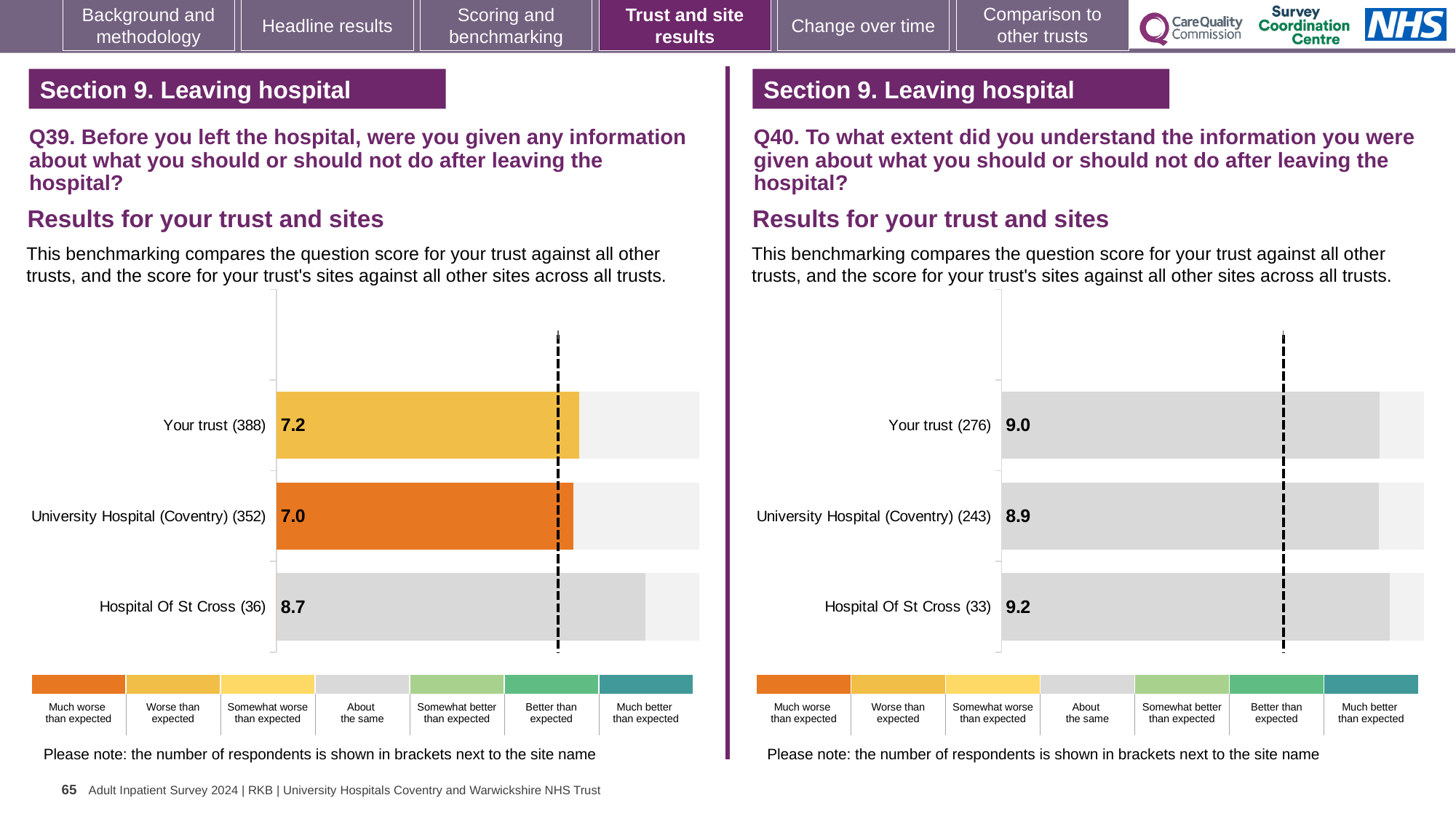
In the Q39 chart, what is the difference between the scores for Hospital Of St Cross (36) and Your trust (388)? 1.5 What kind of chart is used for the Q40 results? Bar chart In the Q40 chart, what is the score for Hospital Of St Cross (33)? 9.2 In the Q39 chart, which site or trust has the highest score? Hospital Of St Cross (36) In the Q39 chart, what is the score for Your trust (388)? 7.2 In the Q39 chart, which benchmark category does the colour of the University Hospital (Coventry) (352) bar correspond to? Much worse than expected In the Q40 chart, what is the difference between the scores for Hospital Of St Cross (33) and University Hospital (Coventry) (243)? 0.3 In the Q40 chart, what is the score for Your trust (276)? 9.0 In the Q40 chart, which site or trust has the lowest score? University Hospital (Coventry) (243) In the Q39 chart, how many bars are plotted? 3 In the Q39 chart, which site or trust has the lowest score? University Hospital (Coventry) (352) In the Q39 chart, what is the score for University Hospital (Coventry) (352)? 7.0